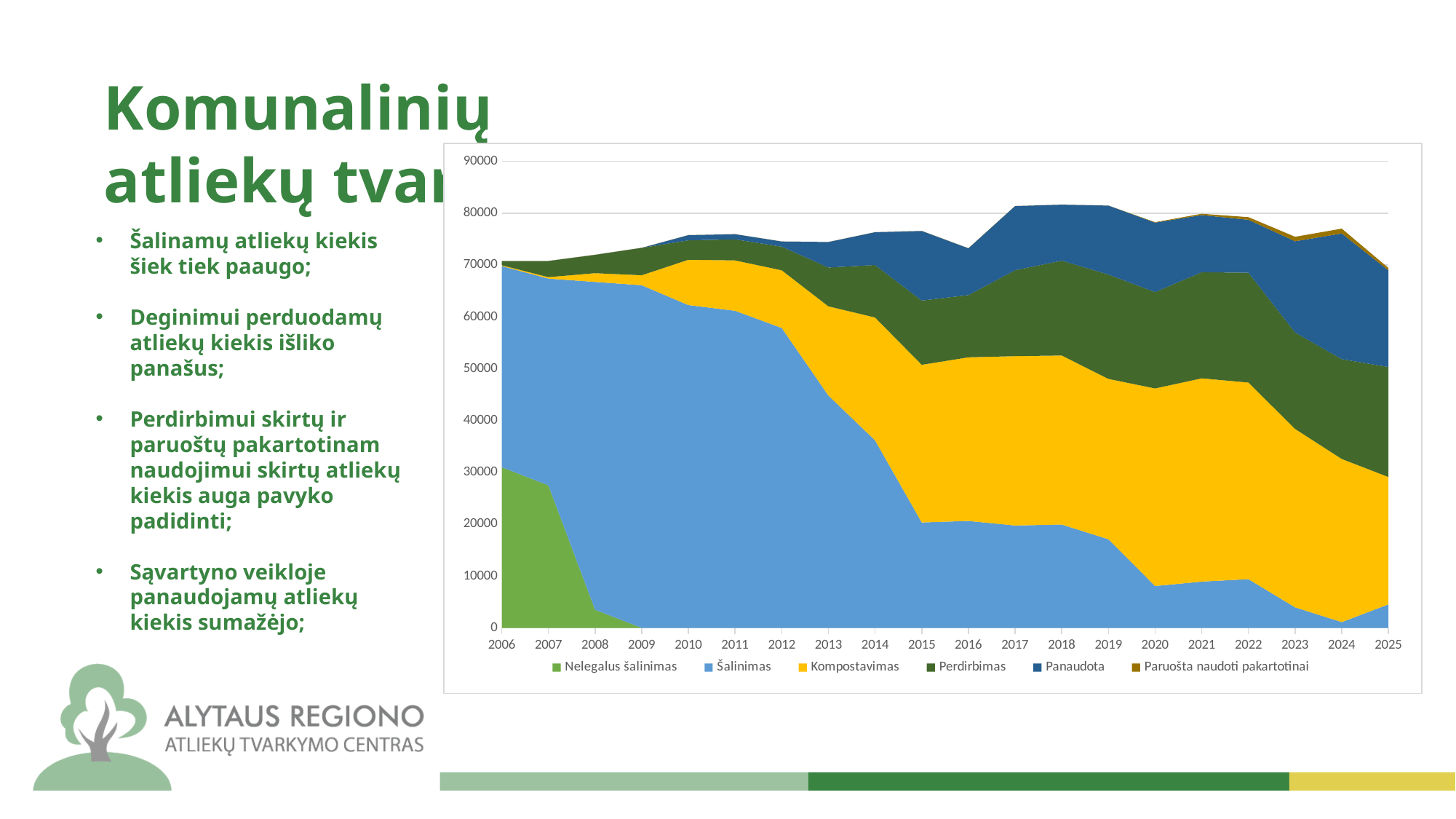
Is the total height of the stacked areas in 2010 greater or less than 80000? less How many years are shown along the x axis of the chart? 20 Is the value for Nelegalus šalinimas in 2006 greater or less than 20000? greater Which year is the first on the x axis of the chart? 2006 Is the total height of the stacked areas in 2017 greater or less than 80000? greater How many series does the chart legend list? 6 Which year is the last on the x axis of the chart? 2025 Does the total height of the stacked areas rise or fall from 2006 to 2017? rise What kind of chart is shown on the slide? stacked area chart Does the value for Šalinimas rise or fall from 2012 to 2015? fall Does the value for Nelegalus šalinimas rise or fall from 2006 to 2009? fall